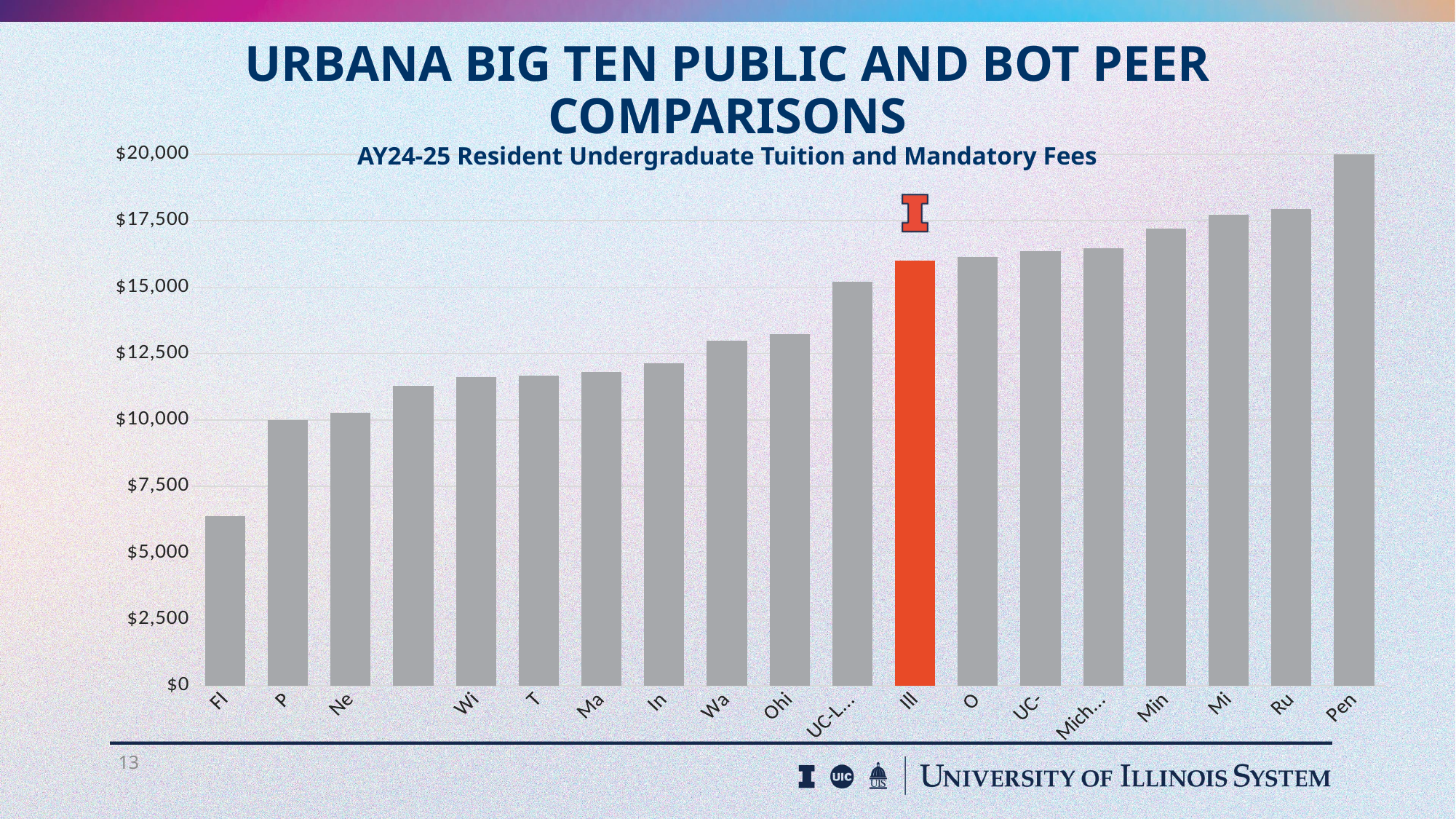
Which category's bar is highlighted in orange? Ill Which category has the highest value? Pen Do the values generally rise or fall from left to right along the x axis? rise What kind of chart is shown on the slide? bar chart Is the value for Pen greater or less than $17,500? greater Is the value for Wi greater or less than $12,500? less Which is larger, the value for Ill or the value for Ohi? Ill Which category has the lowest value? Fl Is the value for Min greater or less than $15,000? greater How many bars are plotted in the chart? 19